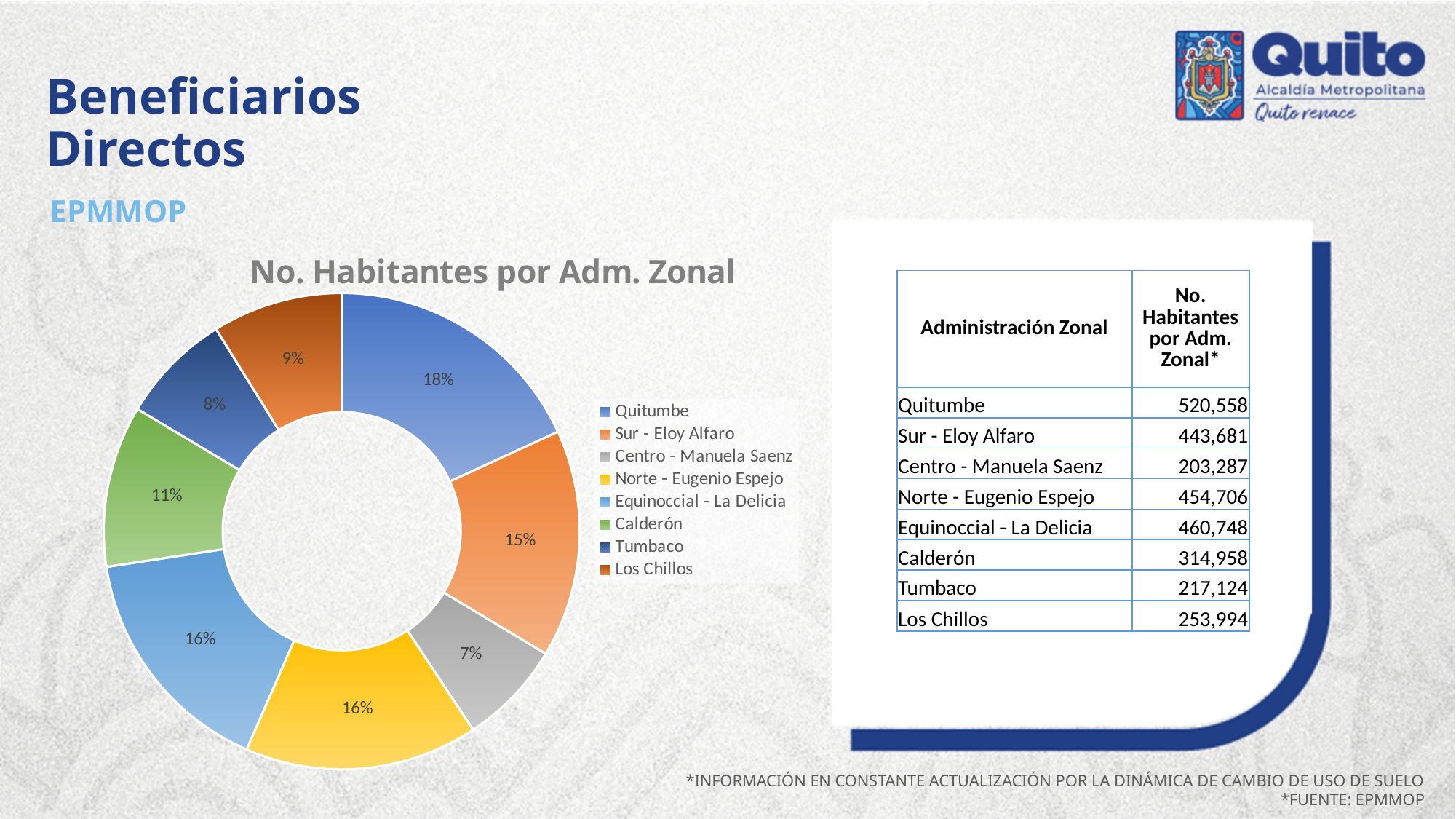
Which legend entry is shown in yellow in the chart? Norte - Eugenio Espejo What is the difference in percentage points between the Quitumbe slice and the Sur - Eloy Alfaro slice? 3 percentage points What percentage share does the Calderón slice show in the chart? 11% Which administración zonal has the smallest share in the chart? Centro - Manuela Saenz How many slices (administraciones zonales) does the chart have? 8 What is the title of the chart on the slide? No. Habitantes por Adm. Zonal What percentage share does the Los Chillos slice show in the chart? 9% Which administración zonal has the largest share in the chart? Quitumbe What percentage share does the Centro - Manuela Saenz slice show in the chart? 7% Which slice is larger in the chart, Tumbaco or Calderón? Calderón What kind of chart is shown under the title "No. Habitantes por Adm. Zonal"? Doughnut (pie) chart